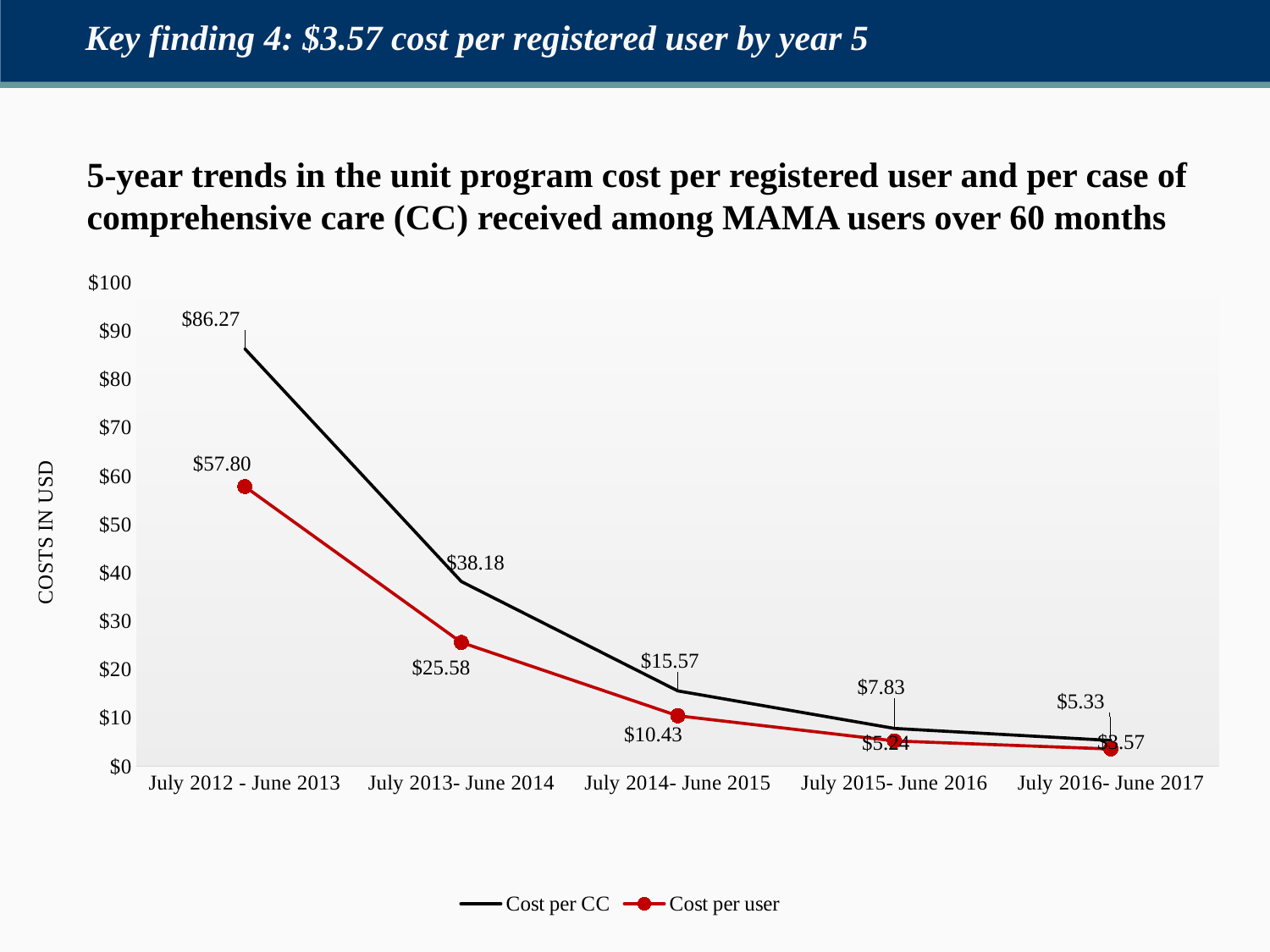
How many series does the legend list? 2 How many time periods are shown on the x axis? 5 What is the Cost per CC for July 2016- June 2017? $5.33 What is the difference between the Cost per CC and the Cost per user in July 2014- June 2015? $5.14 What is the Cost per user for July 2012 - June 2013? $57.80 In which period is the Cost per user lowest? July 2016- June 2017 What is the Cost per user for July 2013- June 2014? $25.58 In which period is the Cost per CC highest? July 2012 - June 2013 What is the Cost per CC for July 2014- June 2015? $15.57 What is the Cost per CC for July 2012 - June 2013? $86.27 Do the Cost per CC values rise or fall across the periods from left to right? Fall What type of chart is shown on the slide? Line chart